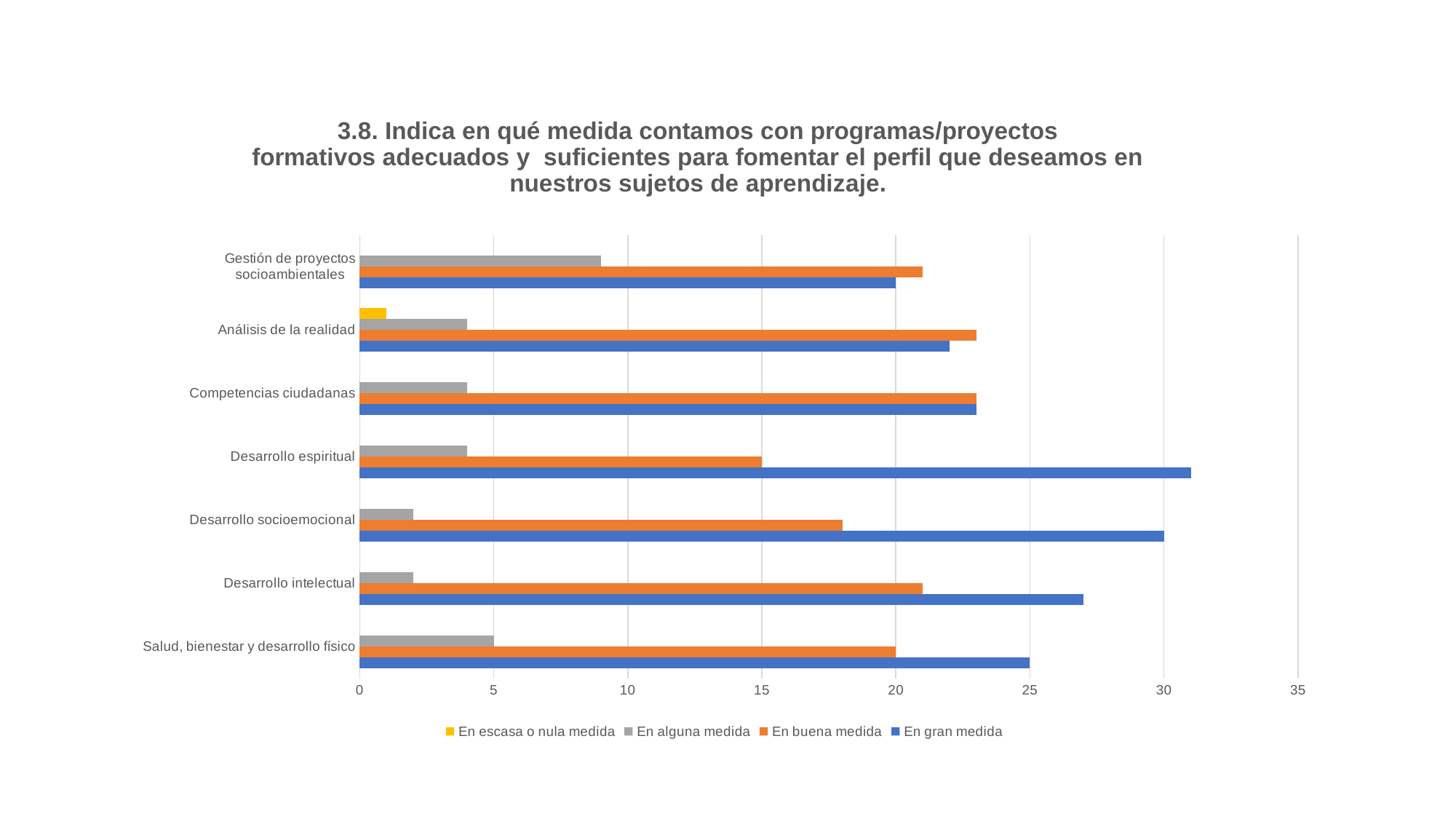
What kind of chart is shown on the slide? bar chart Which category is the only one with a visible bar for 'En escasa o nula medida'? Análisis de la realidad How many series does the legend list? 4 How many categories are shown on the vertical axis? 7 Is the value of 'En gran medida' for Desarrollo intelectual greater or less than 25? greater Which is larger for Desarrollo espiritual: 'En gran medida' or 'En buena medida'? En gran medida Which category has the highest value for 'En gran medida'? Desarrollo espiritual What is the value of 'En gran medida' for Salud, bienestar y desarrollo físico? 25 What is the value of 'En alguna medida' for Salud, bienestar y desarrollo físico? 5 Which category has the highest value for 'En alguna medida'? Gestión de proyectos socioambientales What is the value of 'En gran medida' for Desarrollo socioemocional? 30 What is the value of 'En buena medida' for Desarrollo espiritual? 15